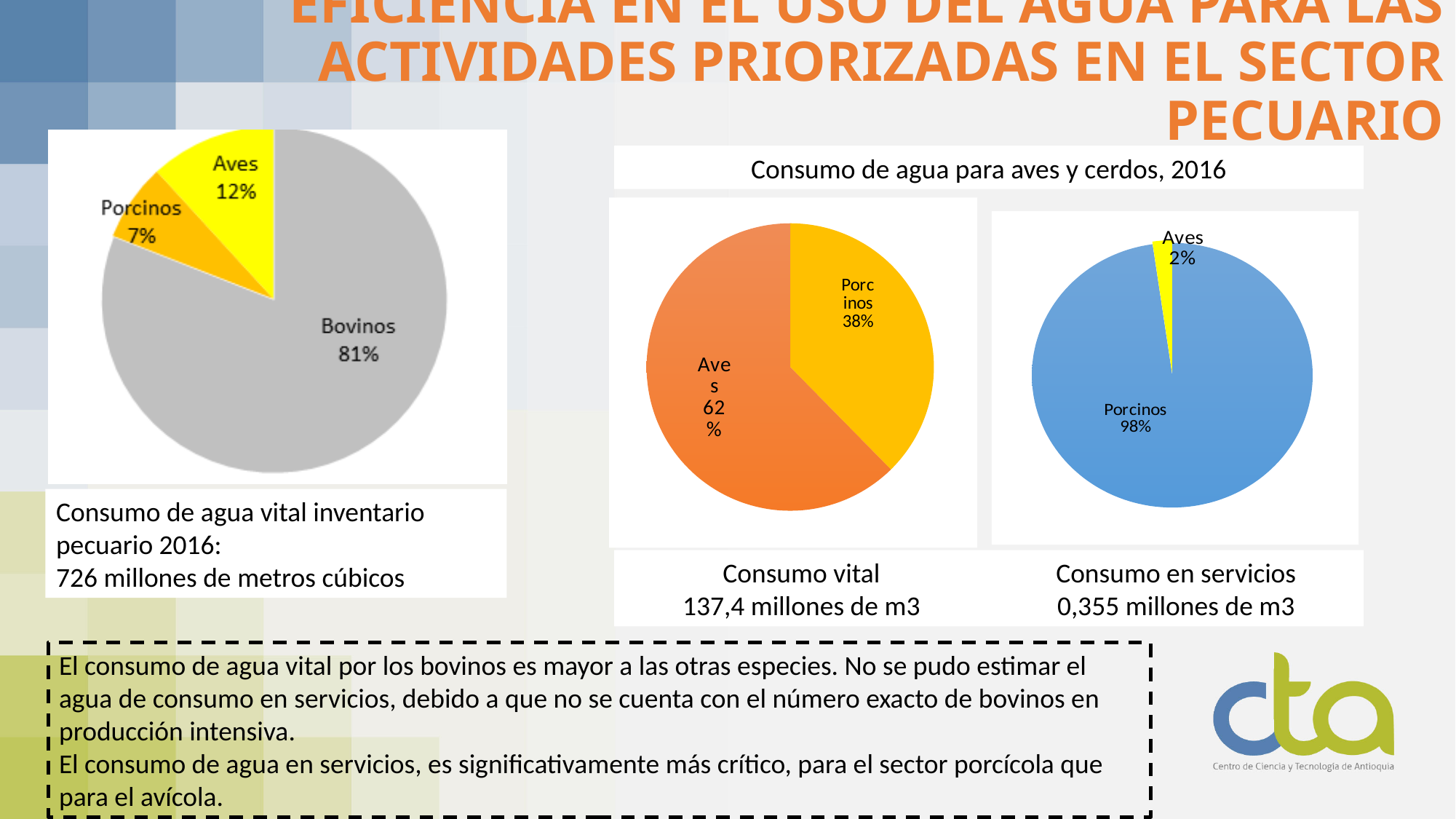
In the right pie chart (Consumo en servicios), what share is labelled for Aves? 2% What type of chart is used for the three charts on the slide? Pie chart In the left pie chart (Consumo de agua vital inventario pecuario 2016), which category has the largest slice? Bovinos In the left pie chart (Consumo de agua vital inventario pecuario 2016), which category has the smallest slice? Porcinos In the left pie chart (Consumo de agua vital inventario pecuario 2016), how many slices are there? 3 In the middle pie chart (Consumo vital), which is larger, Aves or Porcinos? Aves In the left pie chart (Consumo de agua vital inventario pecuario 2016), what share is labelled for Bovinos? 81% In the left pie chart, what is the difference in percentage points between Aves and Porcinos? 5 In the middle pie chart (Consumo vital), what share is labelled for Aves? 62% In the right pie chart (Consumo en servicios), what share is labelled for Porcinos? 98% In the left pie chart (Consumo de agua vital inventario pecuario 2016), what share is labelled for Porcinos? 7% In the middle pie chart (Consumo vital), what share is labelled for Porcinos? 38%